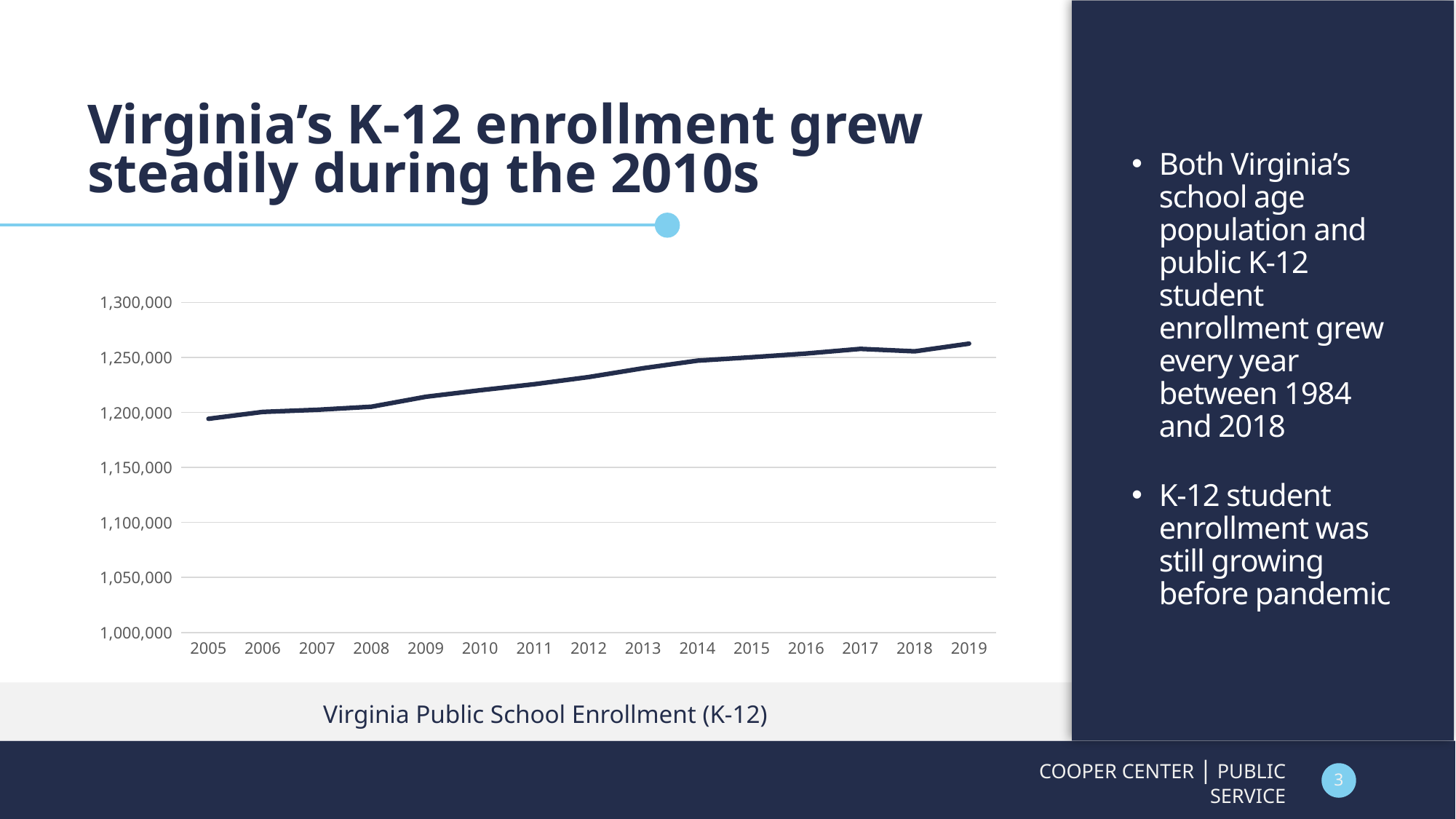
Which year has the lowest enrollment value on the chart? 2005 How many years are plotted along the x axis of the chart? 15 Which year has the larger enrollment value, 2008 or 2015? 2015 Is the enrollment value for 2008 greater or less than 1,150,000? greater What kind of chart is shown on the slide? line chart Which year has the highest enrollment value on the chart? 2019 Which year has the larger enrollment value, 2005 or 2019? 2019 What is the title shown beneath the chart? Virginia Public School Enrollment (K-12) Is the enrollment value for 2014 greater or less than 1,200,000? greater Is the enrollment value for 2019 greater or less than 1,250,000? greater Do the enrollment values generally rise or fall from 2005 to 2019? rise